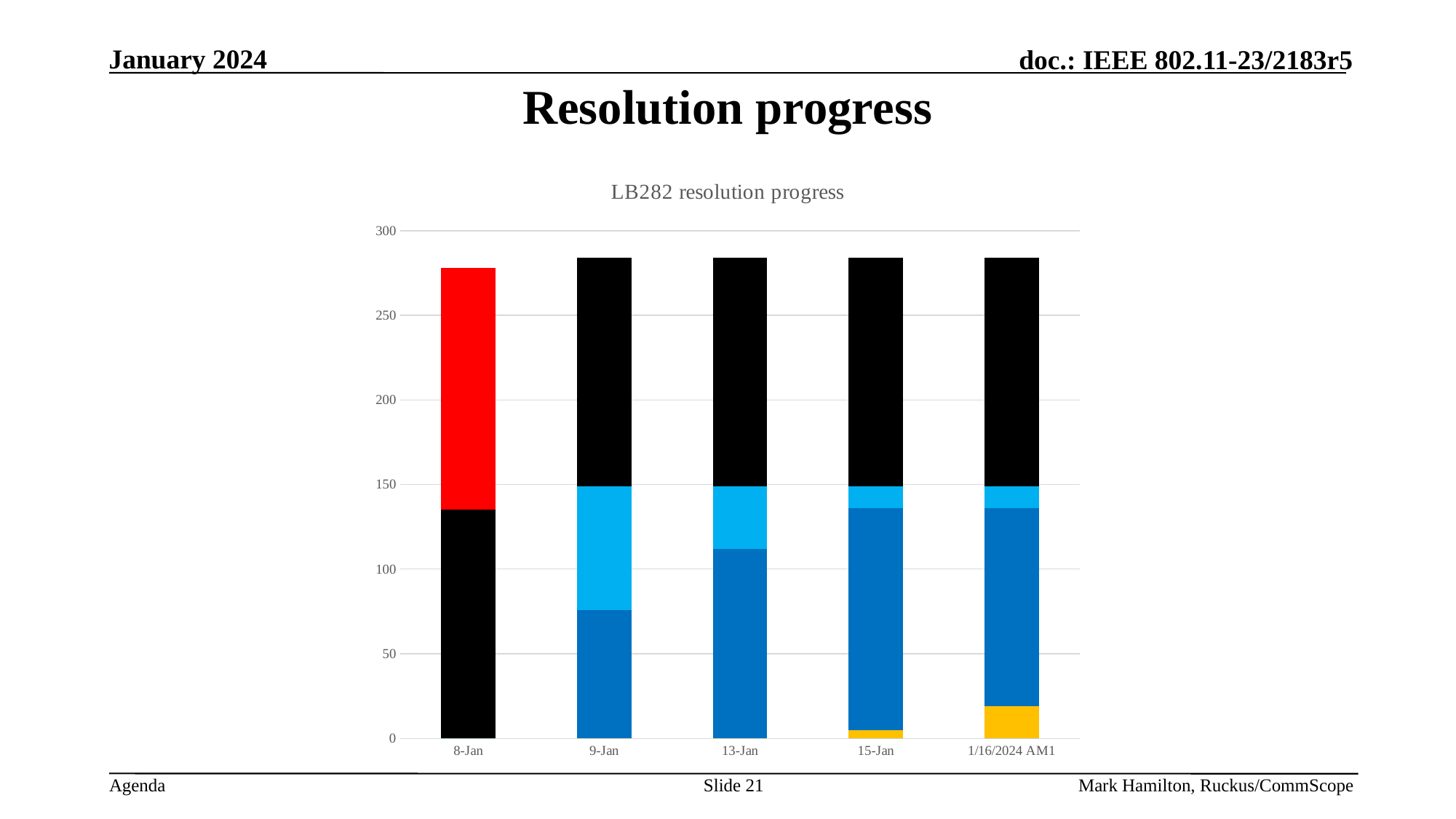
Is the total height of the 9-Jan bar greater or less than 300? less Is the total height of the 8-Jan bar greater or less than 300? less Does the dark blue segment rise or fall from 9-Jan to 1/16/2024 AM1? rise How many dates (categories) are shown on the x axis of the chart? 5 What kind of chart is shown on the slide? Stacked bar chart Which date's bar contains a red segment? 8-Jan Is the total height of the 8-Jan bar greater or less than 250? greater Which bar has a larger dark blue segment, 9-Jan or 13-Jan? 13-Jan What is the title of the chart? LB282 resolution progress